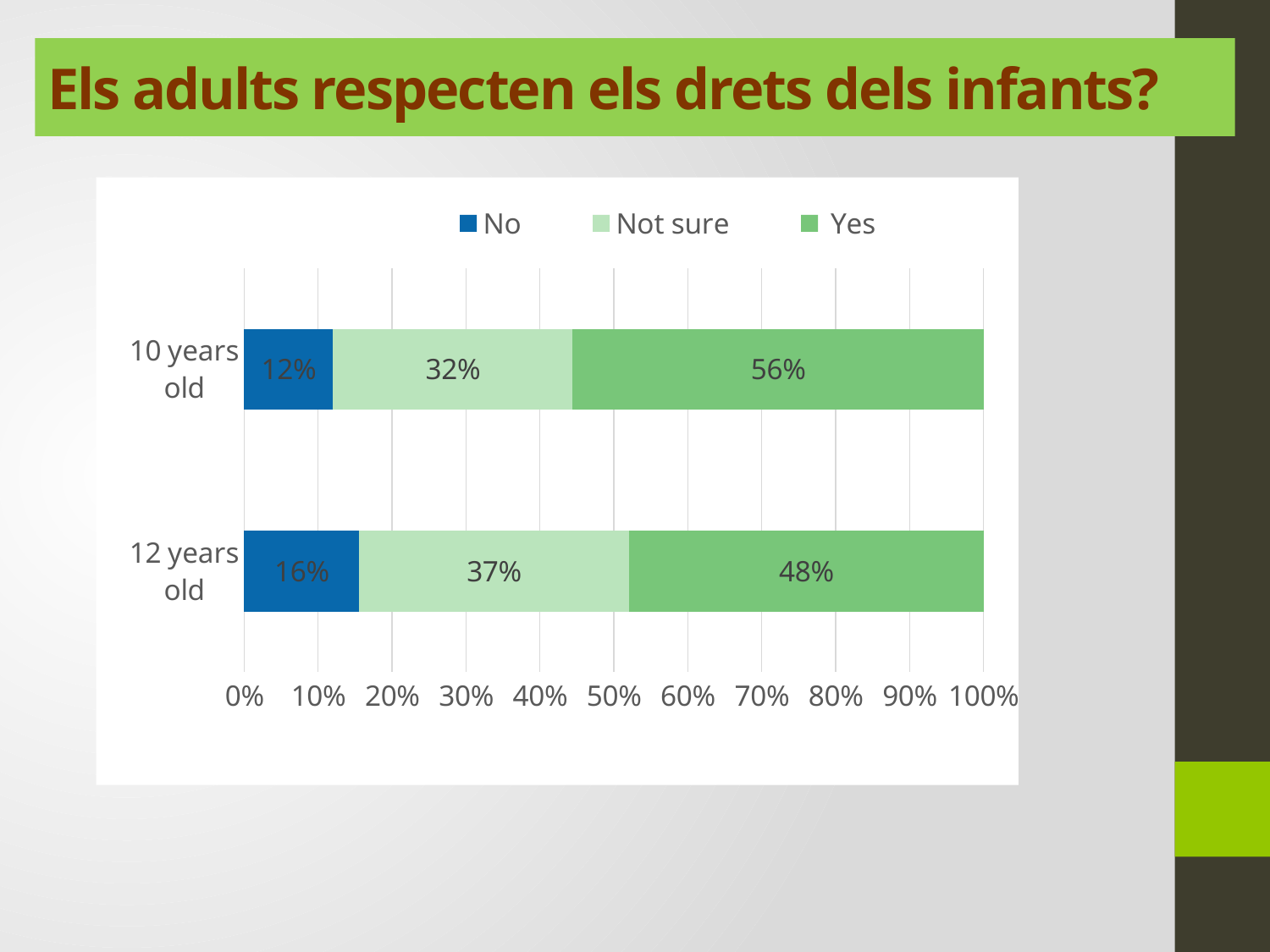
Is the "Not sure" value for 12 years old larger or smaller than the "Not sure" value for 10 years old? larger How many series does the legend list? 3 How many age groups are shown in the chart? 2 What percentage of 12 years old answered "Not sure"? 37% What percentage of 10 years old answered "Not sure"? 32% Which age group has the lower "No" percentage? 10 years old What kind of chart is shown on the slide? Stacked bar chart What is the total of the three segments for the 12 years old bar? 101% What is the difference between the "Yes" percentages for 10 years old and 12 years old? 8% What percentage of 10 years old answered "Yes"? 56% What percentage of 12 years old answered "No"? 16% Which age group has the higher "Yes" percentage? 10 years old